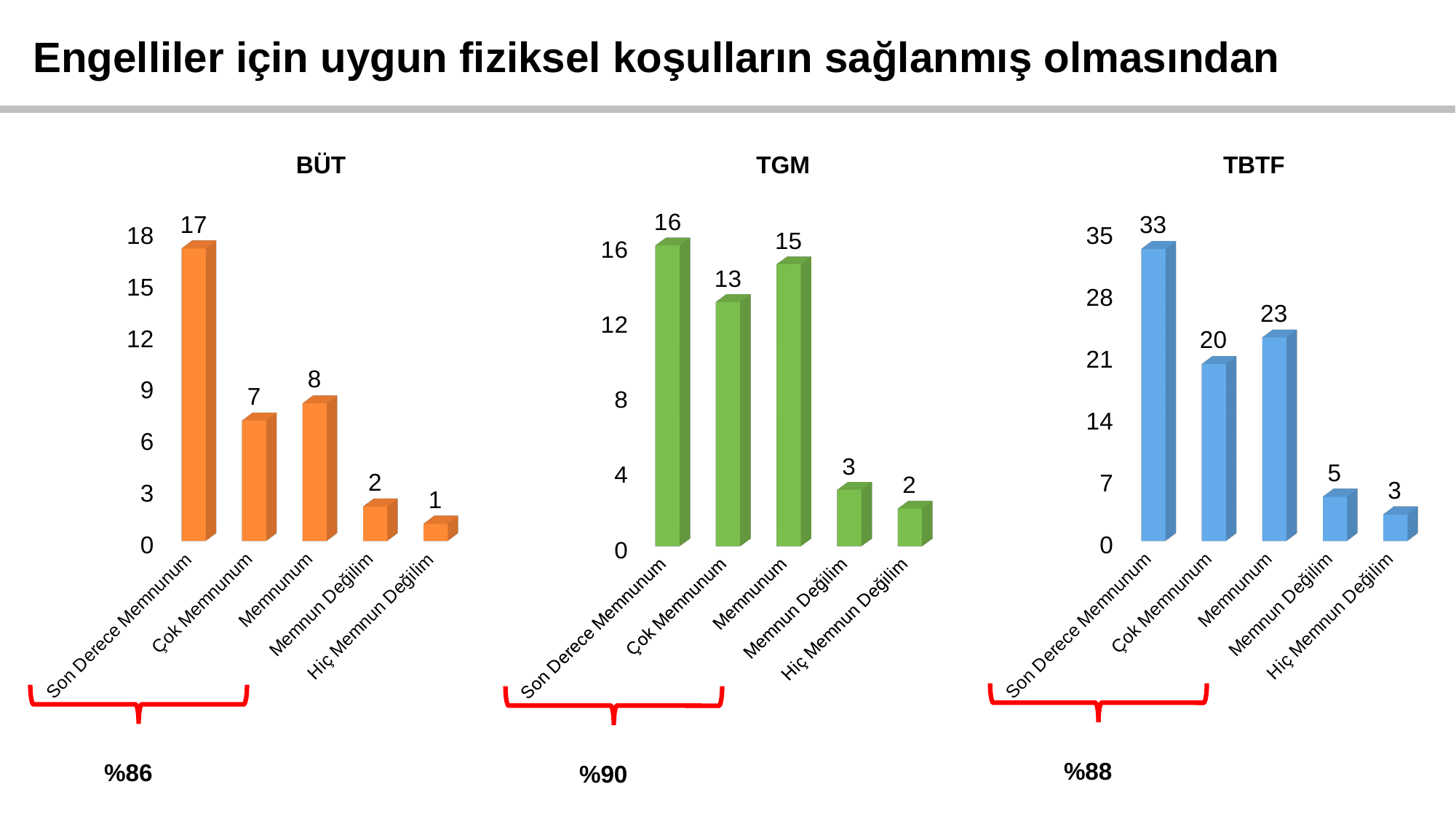
In the TGM chart, is the value for Memnunum greater or less than 12? greater How many categories are shown in the TBTF chart? 5 In the BÜT chart, which category has the lowest value? Hiç Memnun Değilim In the TBTF chart, what is the value for Memnunum? 23 What colour are the bars in the BÜT chart? orange What kind of chart is the TGM chart? bar chart In the TBTF chart, what is the difference between Çok Memnunum and Memnun Değilim? 15 In the TGM chart, what is the difference between Son Derece Memnunum and Memnunum? 1 In the TGM chart, what is the value for Çok Memnunum? 13 In the BÜT chart, which is larger: Çok Memnunum or Memnunum? Memnunum In the TBTF chart, which category has the highest value? Son Derece Memnunum In the BÜT chart, what is the value for Son Derece Memnunum? 17